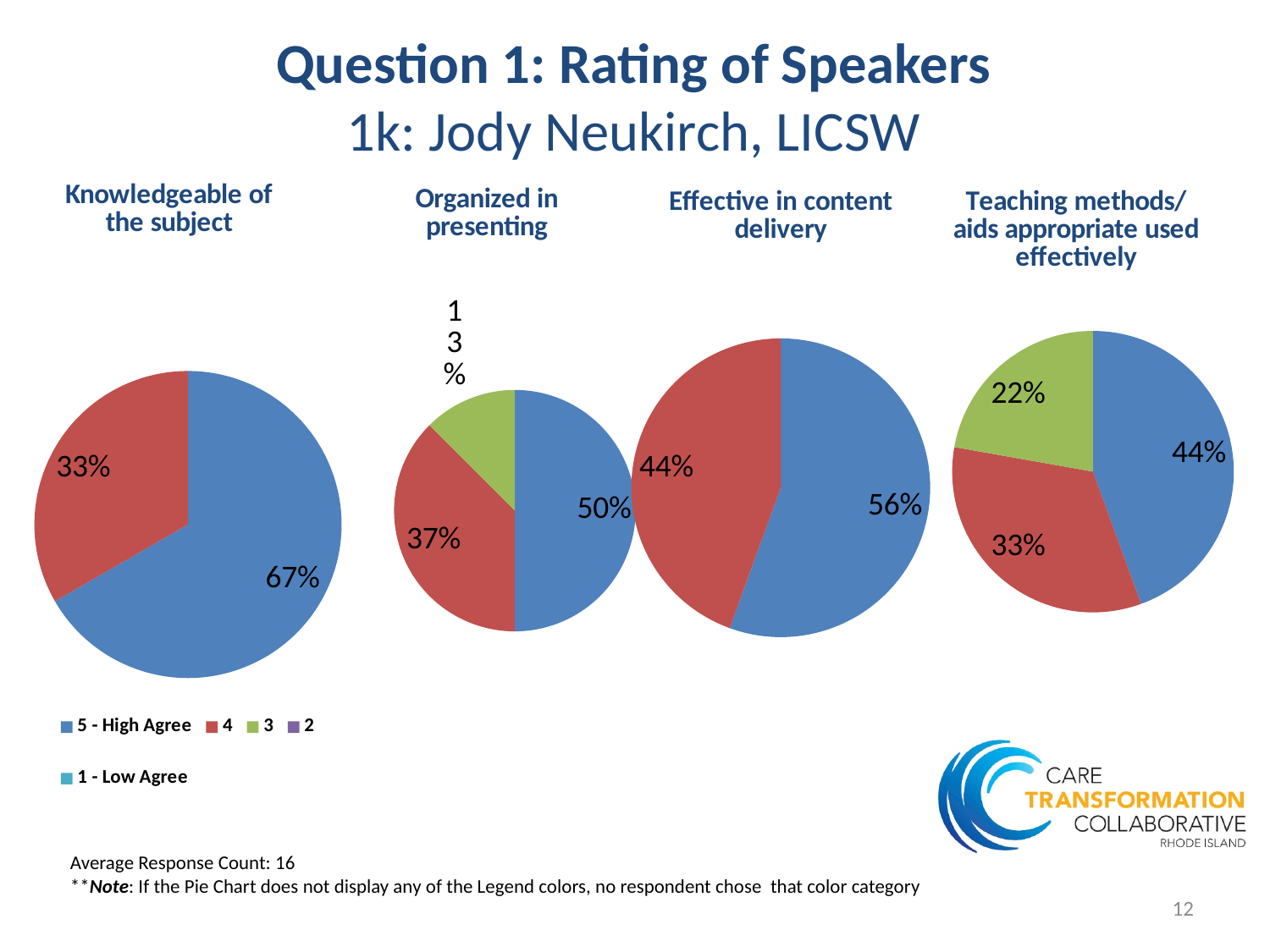
In the 'Organized in presenting' pie chart, which rating category has the smallest slice? 3 How many rating categories does the legend list? 5 In the 'Knowledgeable of the subject' pie chart, what is the difference between the '5 - High Agree' share and the '4' share? 34% In the 'Organized in presenting' pie chart, what share of respondents chose '4'? 37% In the 'Effective in content delivery' pie chart, which is larger: the '5 - High Agree' slice or the '4' slice? 5 - High Agree What type of chart is used to show the ratings on this slide? Pie chart In the 'Teaching methods/aids appropriate used effectively' pie chart, which rating category has the largest slice? 5 - High Agree In the 'Knowledgeable of the subject' pie chart, what share of respondents chose '4'? 33% In the 'Teaching methods/aids appropriate used effectively' pie chart, what share of respondents chose '3'? 22% In the 'Effective in content delivery' pie chart, what share of respondents chose '5 - High Agree'? 56% In the 'Knowledgeable of the subject' pie chart, what share of respondents chose '5 - High Agree'? 67% In the 'Organized in presenting' pie chart, what share of respondents chose '3'? 13%